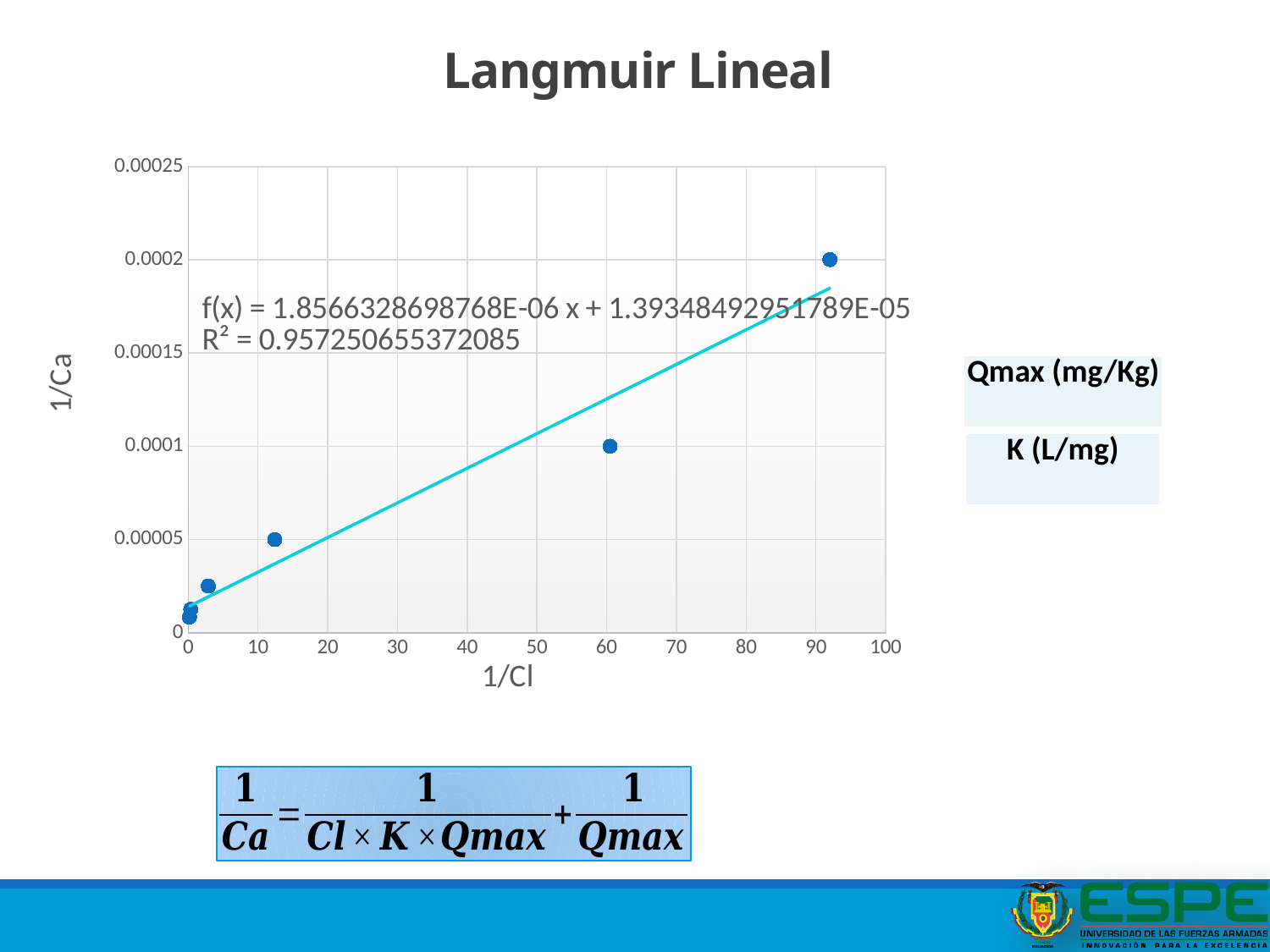
Is the 1/Ca value of the point near 1/Cl = 60 greater or less than 0.00015? less What is the R² value printed on the chart? 0.957250655372085 Is the 1/Ca value of the rightmost point (near 1/Cl = 90) greater or less than 0.00015? greater What is the slope of the trendline equation printed on the chart? 1.8566328698768E-06 What is the intercept of the trendline equation printed on the chart? 1.39348492951789E-05 What is the title of the chart? Langmuir Lineal What kind of chart is shown on the slide? scatter chart Which point has the larger 1/Ca value, the one near 1/Cl = 60 or the one near 1/Cl = 90? the one near 1/Cl = 90 Is the 1/Ca value of the point near 1/Cl = 60 greater or less than 0.00005? greater What are the labels of the x axis and the y axis of the chart? 1/Cl and 1/Ca Do the plotted 1/Ca values rise or fall as 1/Cl increases along the x axis? rise